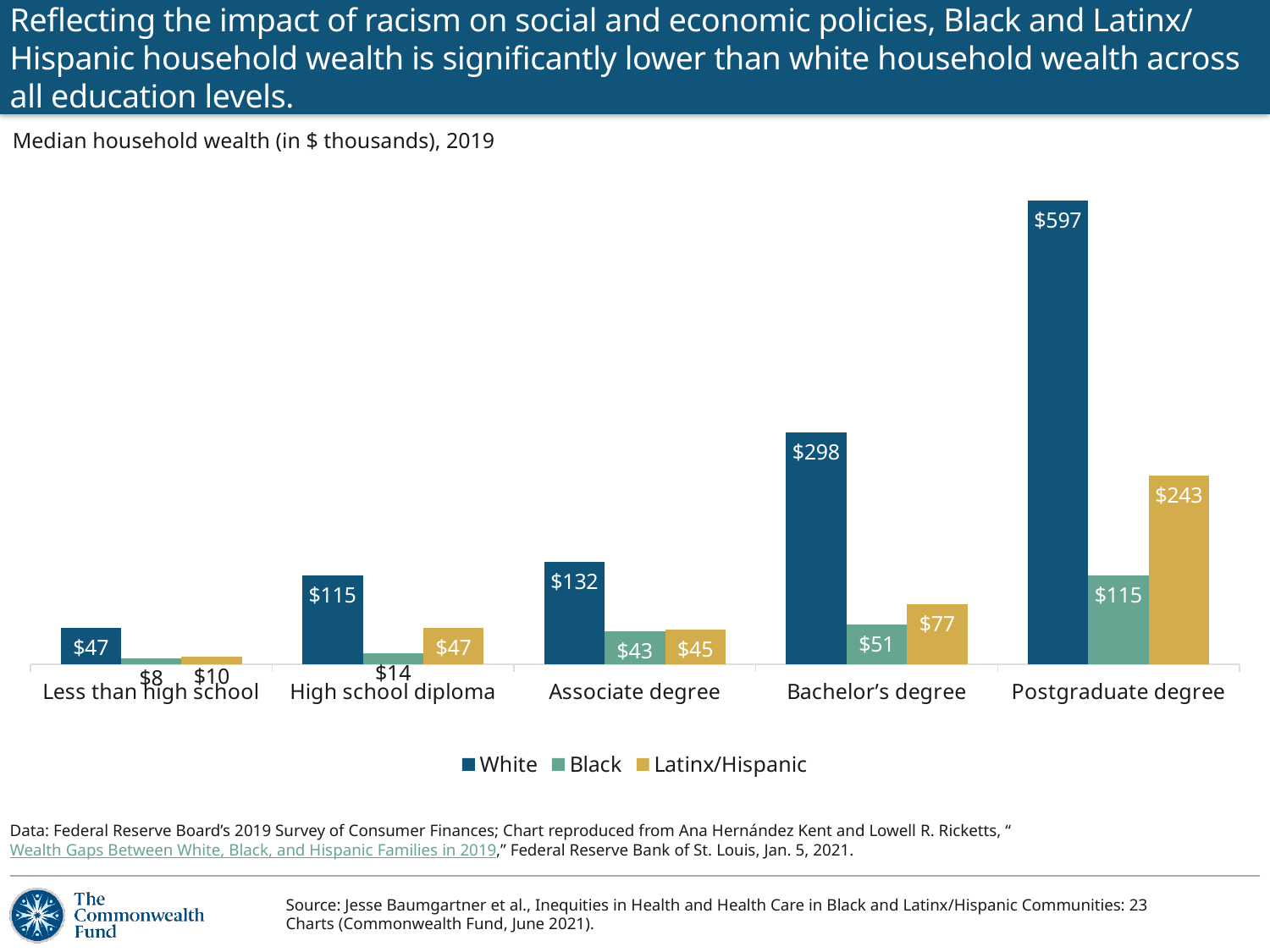
What is the median household wealth for White households with a postgraduate degree? $597 What is the difference between White and Black median household wealth for those with a postgraduate degree? $482 What is the median household wealth for Latinx/Hispanic households with less than high school? $10 How many series does the legend list? 3 Which education level has the lowest median household wealth for Black households? Less than high school What is the median household wealth for Black households with a bachelor's degree? $51 What is the difference between White and Latinx/Hispanic median household wealth for those with a bachelor's degree? $221 How many education levels are shown on the x axis? 5 Which is larger: Black or Latinx/Hispanic median household wealth for those with a high school diploma? Latinx/Hispanic What kind of chart is shown on the slide? Bar chart Does White median household wealth rise or fall as education level increases from left to right? Rise Which education level has the highest median household wealth for Latinx/Hispanic households? Postgraduate degree